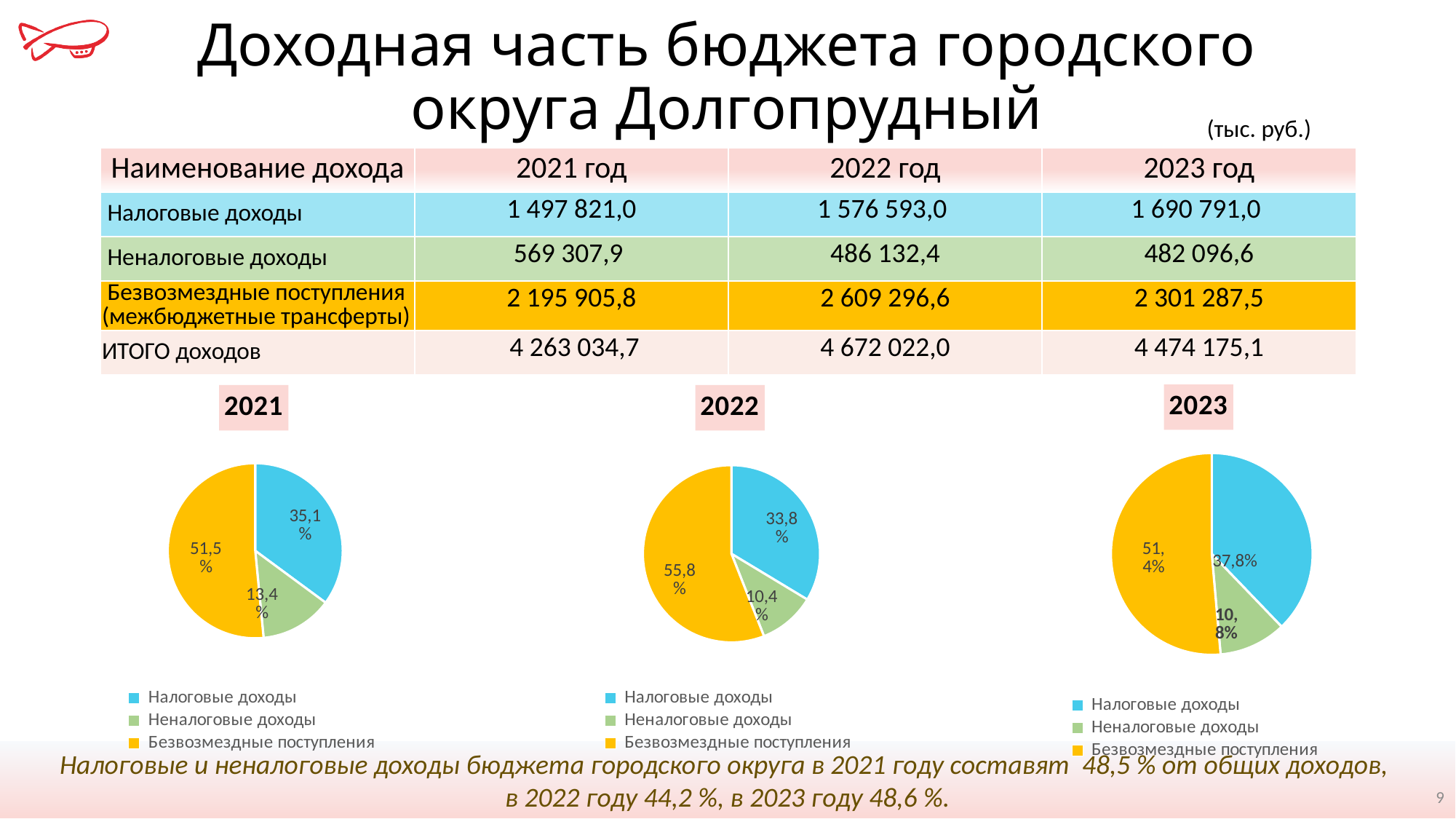
In the 2023 pie chart, what share is shown for Неналоговые доходы? 10,8% In the 2021 pie chart, what is the difference between the shares of Налоговые доходы and Неналоговые доходы? 21,7 percentage points In the 2021 pie chart, what share is shown for Налоговые доходы? 35,1% In the 2022 pie chart, what share is shown for Безвозмездные поступления? 55,8% In the 2022 pie chart, what is the difference between the shares of Безвозмездные поступления and Налоговые доходы? 22,0 percentage points How many slices does the 2023 pie chart have? 3 How many entries does the legend of the 2022 pie chart list? 3 In the 2022 pie chart, which category has the smallest slice? Неналоговые доходы In the 2023 pie chart, which is larger: Налоговые доходы or Неналоговые доходы? Налоговые доходы In the 2021 pie chart, which category has the largest slice? Безвозмездные поступления In the 2023 pie chart, what colour is the slice for Безвозмездные поступления? Yellow What type of chart is used for the 2021, 2022 and 2023 charts? Pie chart